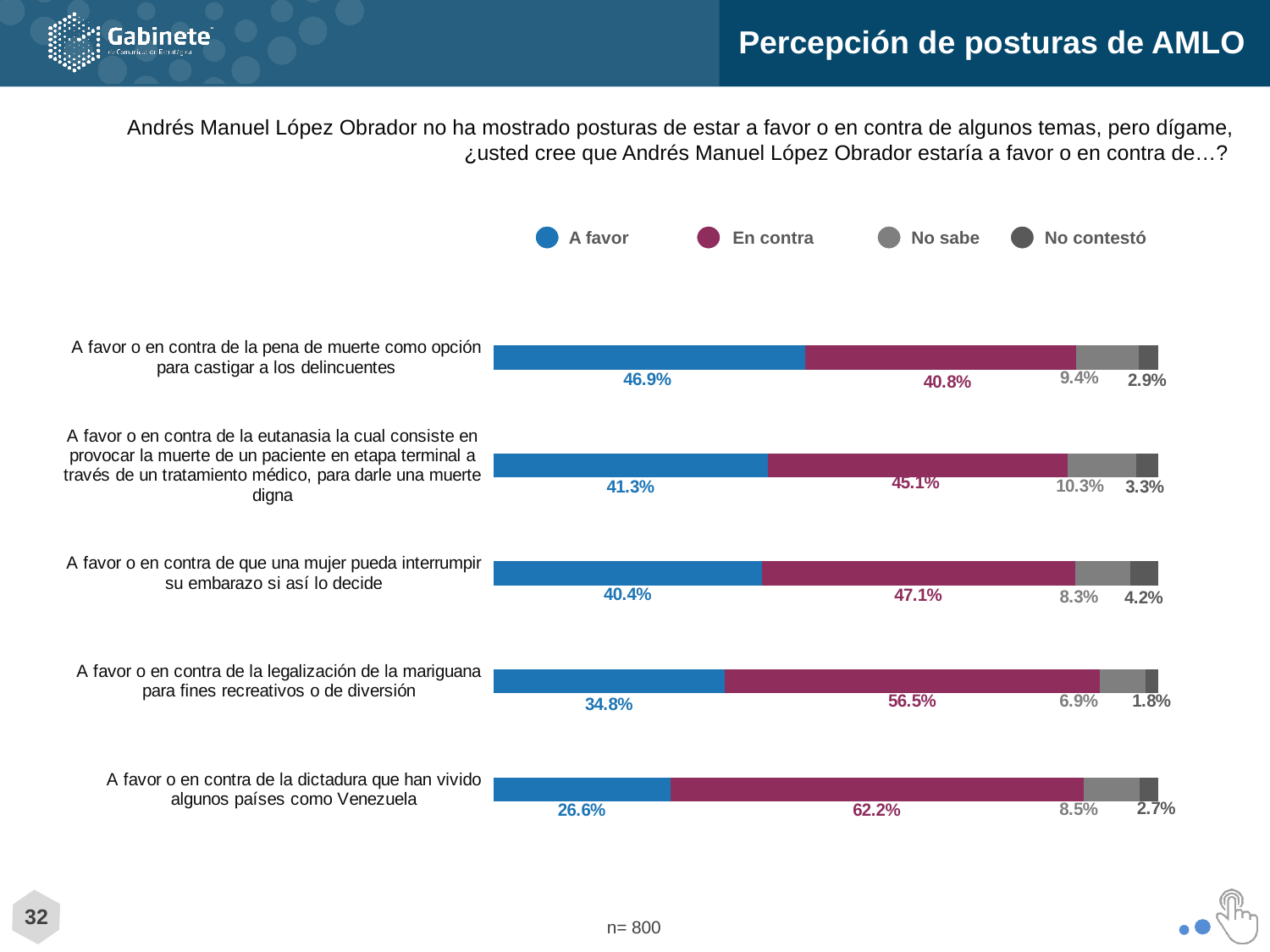
Which topic has the highest 'En contra' percentage? La dictadura que han vivido algunos países como Venezuela How many topics (categories) are shown in the chart? 5 What is the 'En contra' value for the legalization of marijuana for recreational purposes? 56.5% What is the 'No contestó' value for the item about a woman being able to interrupt her pregnancy? 4.2% What is the 'No sabe' value for euthanasia (eutanasia)? 10.3% What type of chart is shown on the slide? Stacked bar chart For the death penalty item, which is larger: 'A favor' or 'En contra'? A favor How many series does the legend list? 4 What is the difference between the 'En contra' and 'A favor' values for the dictatorship (Venezuela) item? 35.6% What percentage of respondents think AMLO would be 'A favor' of the death penalty (pena de muerte) as an option to punish criminals? 46.9% Which topic has the lowest 'A favor' percentage? La dictadura que han vivido algunos países como Venezuela What is the sample size (n) shown at the bottom of the slide? n= 800